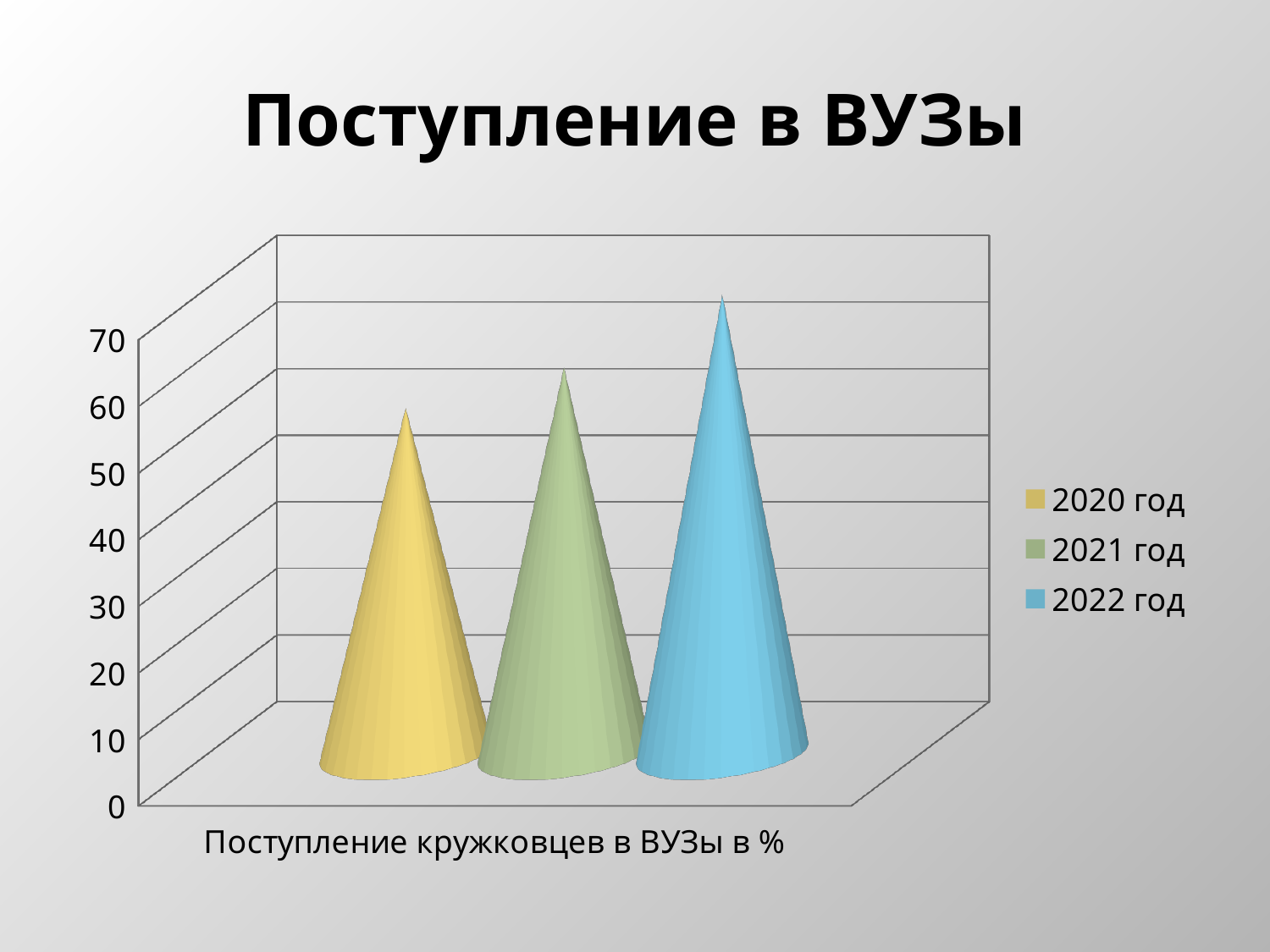
Which is larger, the value for 2021 год or the value for 2020 год? 2021 год Which is larger, the value for 2020 год or the value for 2022 год? 2022 год How many categories are shown on the x axis of the chart? 1 Is the value for 2022 год greater or less than 50? greater Is the value for 2020 год greater or less than 30? greater Which series has the lowest value in the chart? 2020 год What is the title of the chart on the slide? Поступление в ВУЗы What is the category label shown under the chart's x axis? Поступление кружковцев в ВУЗы в % How many series does the chart legend list? 3 Do the values rise or fall from 2020 год to 2022 год? rise Which series has the highest value in the chart? 2022 год Is the value for 2021 год greater or less than 40? greater